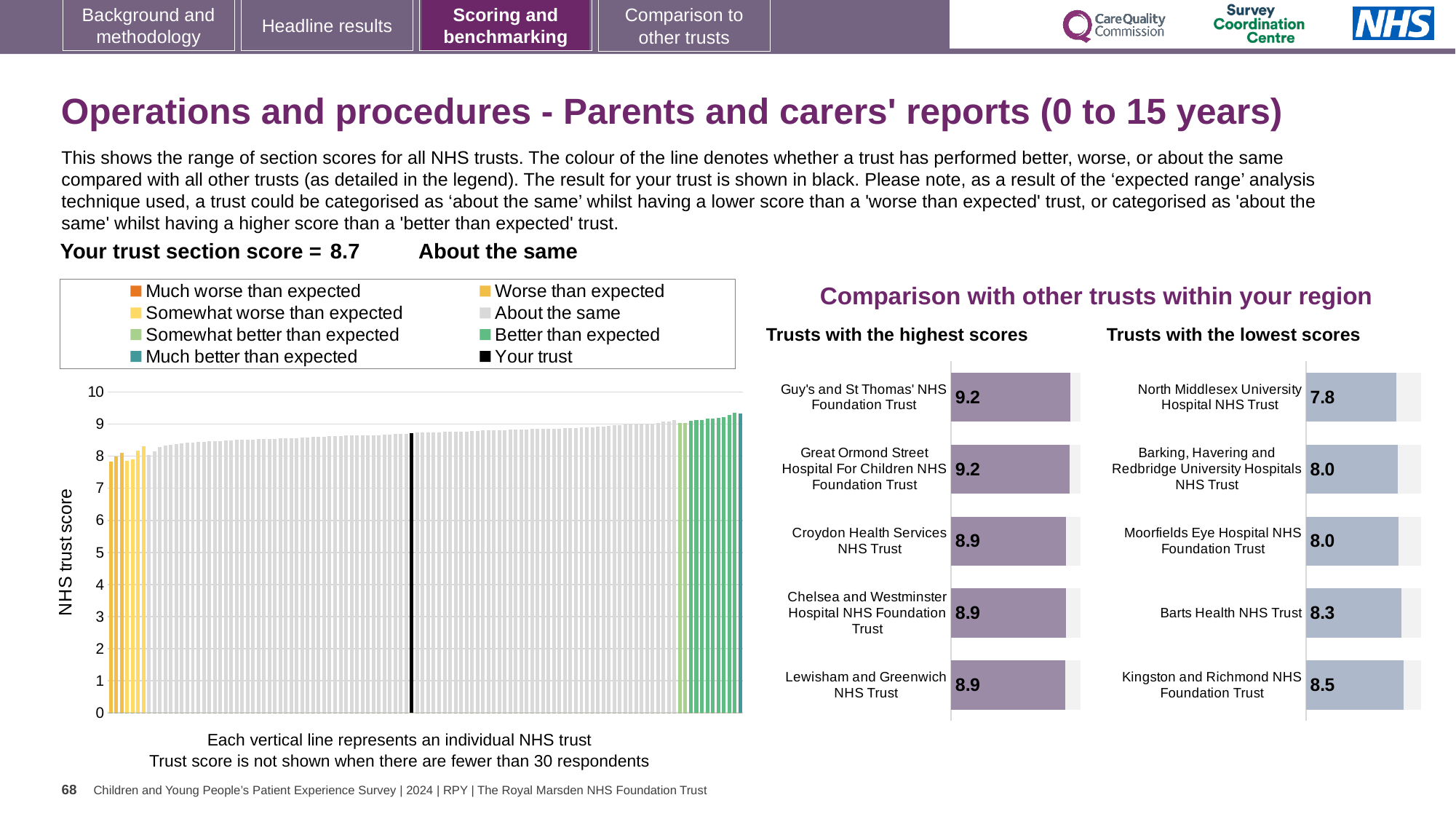
In the 'Trusts with the lowest scores' chart, what is the score for Barts Health NHS Trust? 8.3 In the large 'NHS trust score' chart on the left, what is the section score for your trust (the black bar)? 8.7 In the 'Trusts with the highest scores' chart, what is the difference between the scores of Guy's and St Thomas' NHS Foundation Trust and Lewisham and Greenwich NHS Trust? 0.3 In the 'Trusts with the lowest scores' chart, which has the higher score: Barts Health NHS Trust or Moorfields Eye Hospital NHS Foundation Trust? Barts Health NHS Trust How many trusts are shown in the 'Trusts with the highest scores' chart? 5 In the 'Trusts with the highest scores' chart, what is the score for Croydon Health Services NHS Trust? 8.9 In the 'Trusts with the lowest scores' chart, what is the difference between the scores of Kingston and Richmond NHS Foundation Trust and North Middlesex University Hospital NHS Trust? 0.7 In the 'Trusts with the lowest scores' chart, what is the score for North Middlesex University Hospital NHS Trust? 7.8 What kind of chart is the large 'NHS trust score' chart on the left of the slide? bar chart In the 'Trusts with the lowest scores' chart, which trust has the highest score? Kingston and Richmond NHS Foundation Trust How many entries does the legend above the large 'NHS trust score' chart list? 8 In the 'Trusts with the lowest scores' chart, which trust has the lowest score? North Middlesex University Hospital NHS Trust